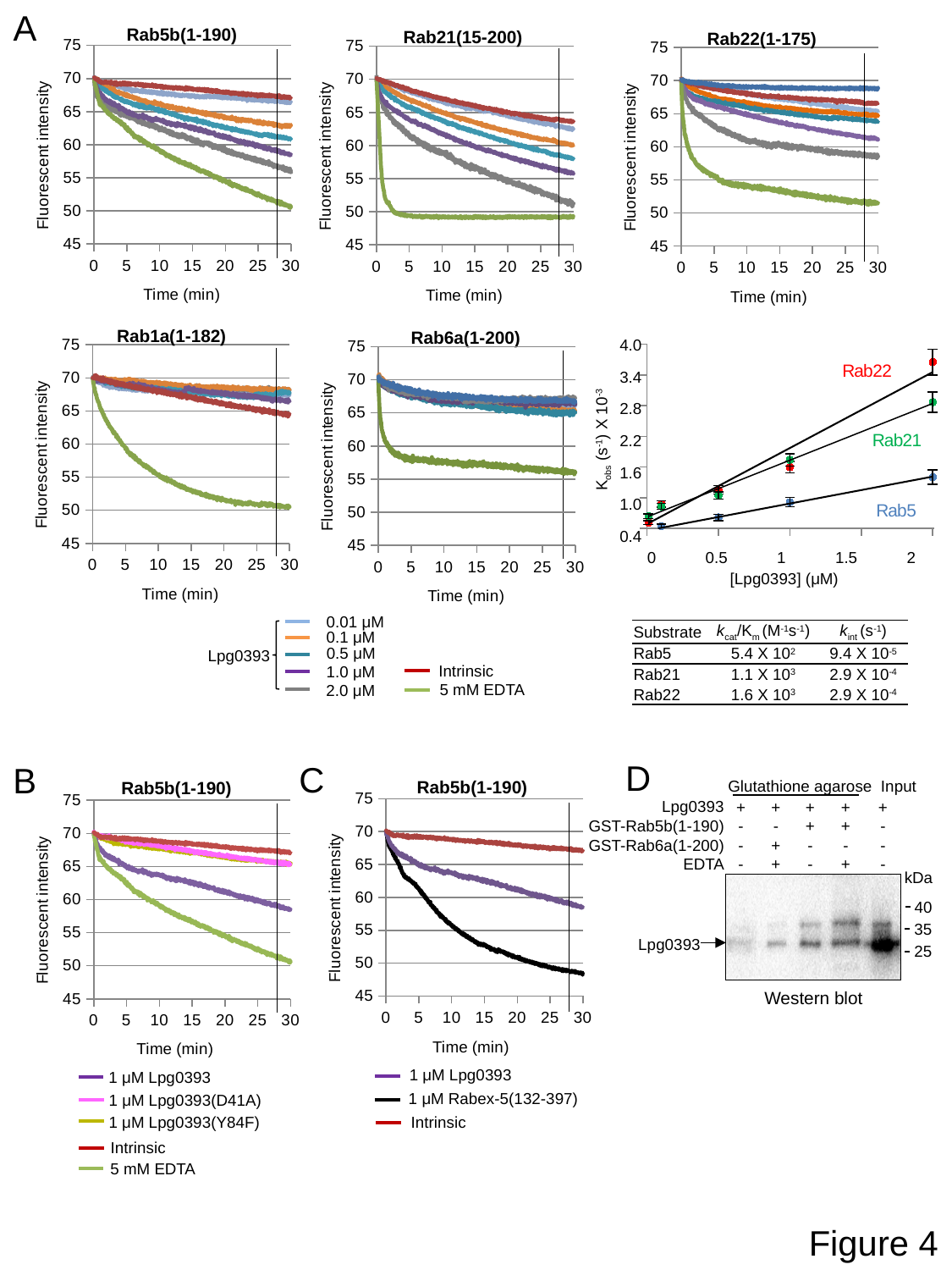
In the Rab6a(1-200) chart in panel A, is the 5 mM EDTA value at 30 min greater or less than 60? less How many series does the legend of the panel C Rab5b(1-190) chart list? 3 In the Rab5b(1-190) chart in panel A, does the 5 mM EDTA curve rise or fall over time? fall What is the x-axis label of the Kobs chart in panel A? [Lpg0393] (µM) In the panel B Rab5b(1-190) chart, which series has the lowest fluorescent intensity at 30 min? 5 mM EDTA How many entries does the legend for the panel A charts list (Lpg0393 concentrations plus controls)? 7 What kind of chart is the Rab5b(1-190) chart in panel A? line chart In the Kobs versus [Lpg0393] chart in panel A, which Rab has the highest Kobs at the highest Lpg0393 concentration? Rab22 In the Rab22(1-175) chart in panel A, is the 2.0 µM Lpg0393 value at 30 min greater or less than 55? greater How many series does the legend of the panel B Rab5b(1-190) chart list? 5 In the Rab1a(1-182) chart in panel A, is the 5 mM EDTA value at 30 min greater or less than 55? less In the panel C Rab5b(1-190) chart, which is higher at 30 min: Intrinsic or 1 µM Rabex-5(132-397)? Intrinsic